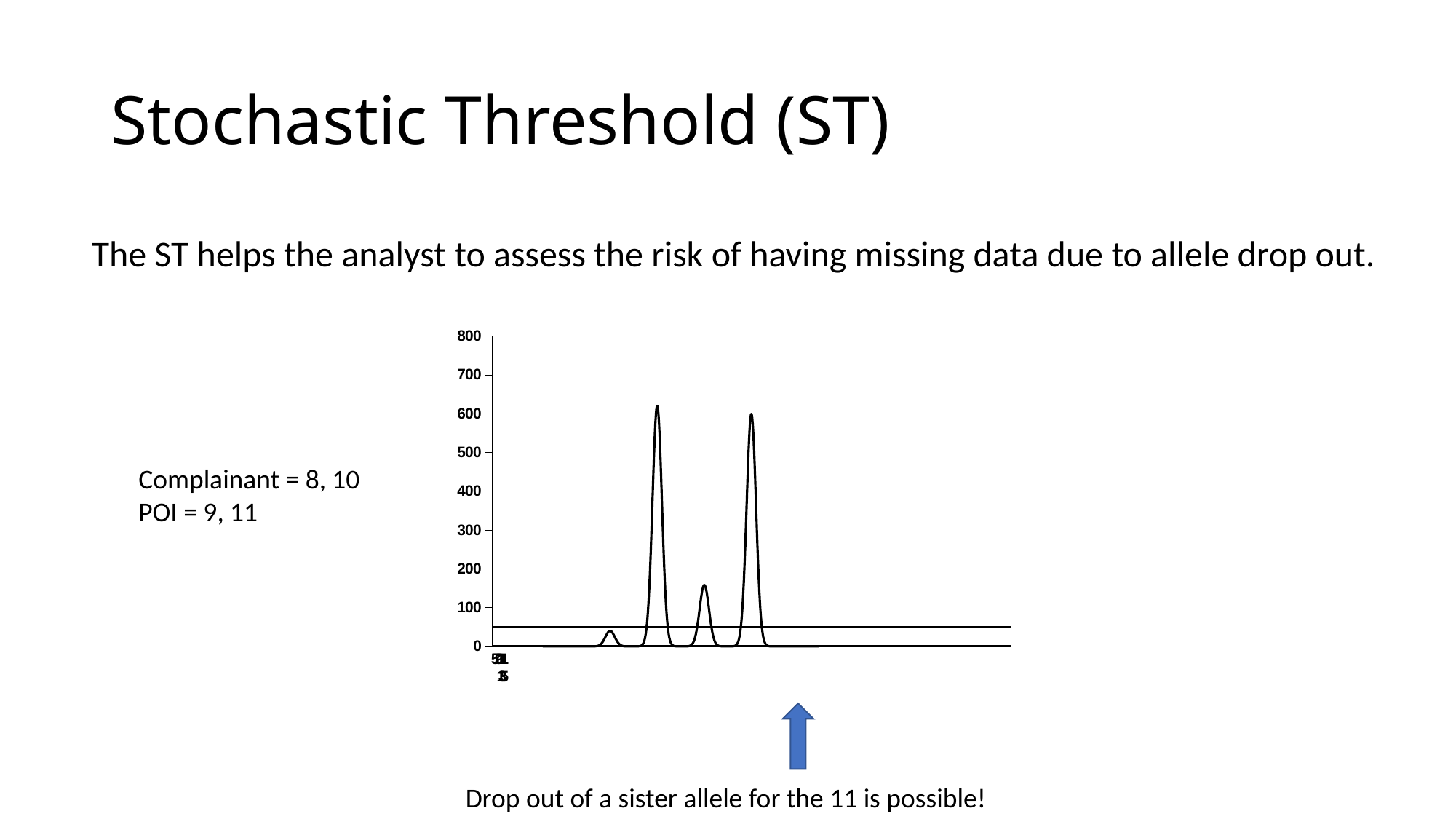
Is the value of the third peak from the left greater or less than 100? greater What kind of chart is shown on the slide? line chart What is the highest value shown on the chart's vertical axis? 800 Is the value of the smallest (leftmost) peak on the chart greater or less than 100? less At what vertical-axis value is the dashed horizontal line drawn on the chart? 200 Is the value of the tallest peak on the chart greater or less than 500? greater How many peaks are plotted on the chart? 4 Which peak on the chart is the lowest? the leftmost peak How many peaks on the chart rise above the dashed line at 200? 2 Which is larger: the second peak from the left or the third peak from the left? the second peak from the left